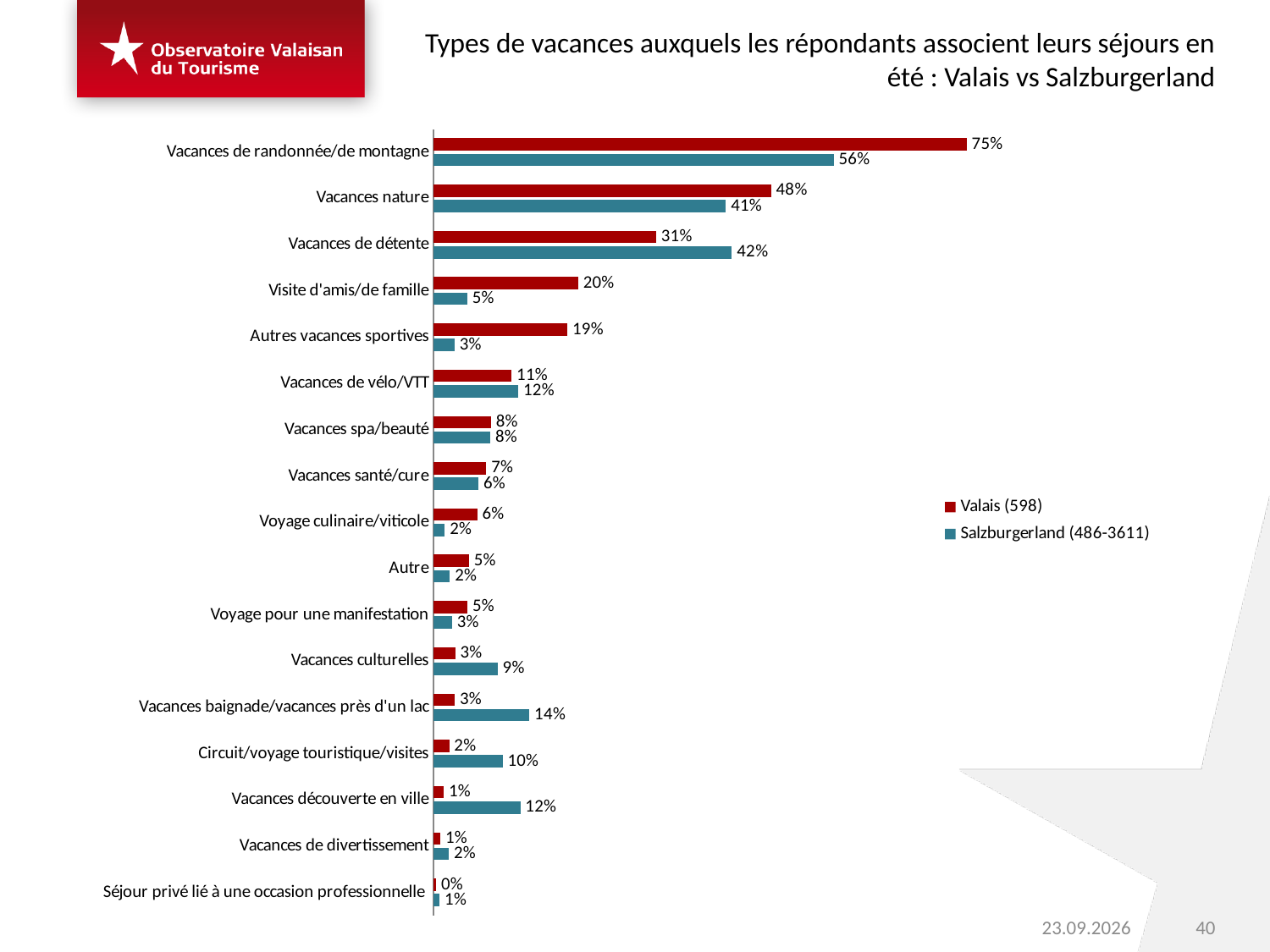
How many series does the legend list? 2 What is the Salzburgerland value for Vacances baignade/vacances près d'un lac? 14% Which category has the highest Valais value? Vacances de randonnée/de montagne What kind of chart is shown on the slide? Bar chart What is the difference between the Salzburgerland and Valais values for Vacances découverte en ville? 11% What is the Salzburgerland value for Vacances de détente? 42% For Visite d'amis/de famille, which series has the larger value, Valais or Salzburgerland? Valais Which category has the lowest Salzburgerland value? Séjour privé lié à une occasion professionnelle For Vacances de détente, which series has the larger value, Valais or Salzburgerland? Salzburgerland What is the Valais value for Vacances de randonnée/de montagne? 75% How many categories are shown on the chart? 17 What is the difference between the Valais and Salzburgerland values for Vacances de randonnée/de montagne? 19%